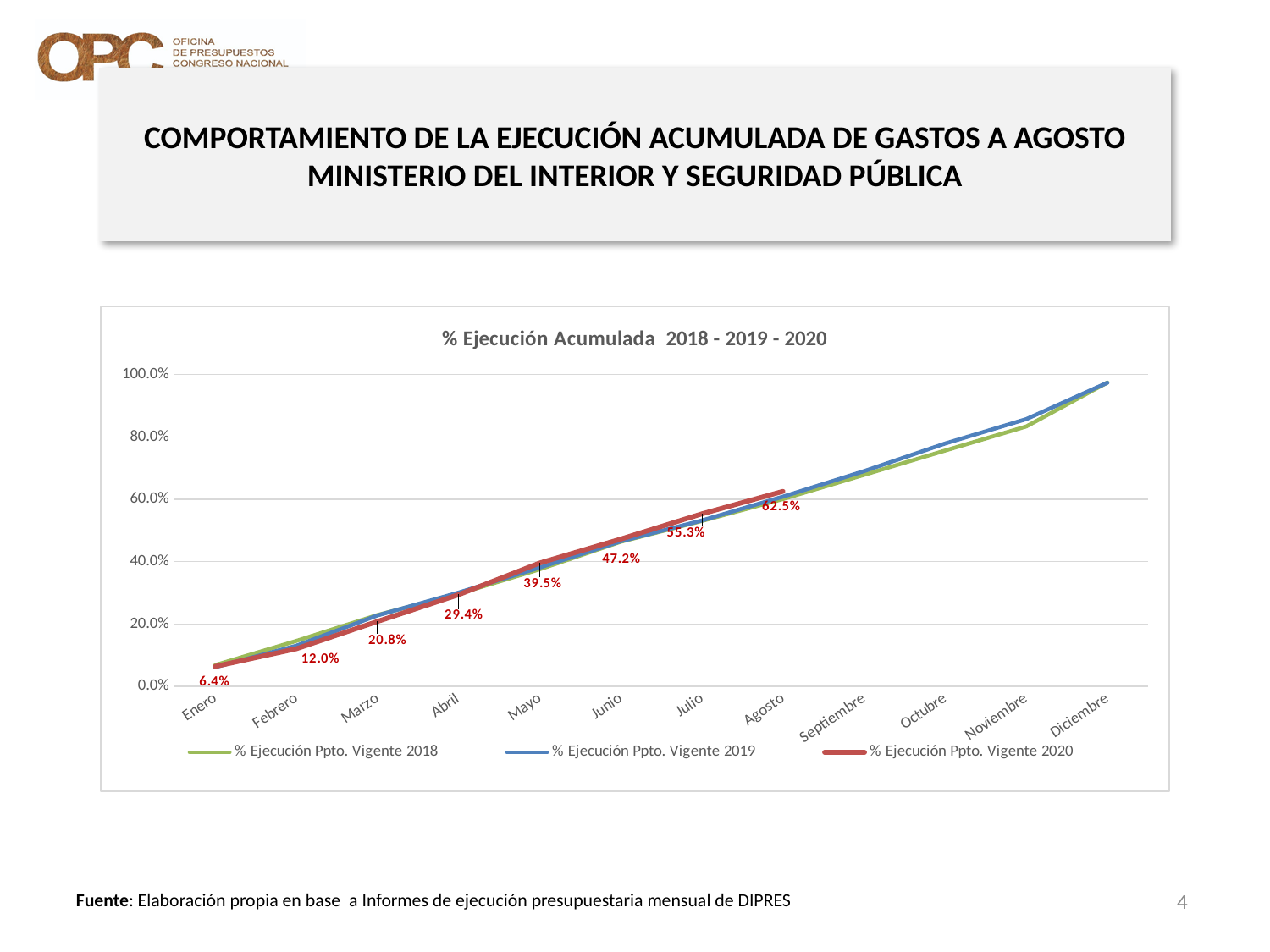
What is the value of % Ejecución Ppto. Vigente 2020 for Mayo? 39.5% What is the value of % Ejecución Ppto. Vigente 2020 for Marzo? 20.8% Is the value for % Ejecución Ppto. Vigente 2018 in Octubre greater or less than 80.0%? less Is the value for % Ejecución Ppto. Vigente 2019 in Diciembre greater or less than 80.0%? greater What is the value of % Ejecución Ppto. Vigente 2020 for Agosto? 62.5% Which month has the highest value for the % Ejecución Ppto. Vigente 2020 series? Agosto Do the values of the series rise or fall from Enero to Diciembre? rise What is the value of % Ejecución Ppto. Vigente 2020 for Enero? 6.4% What kind of chart is shown on the slide? line chart By how many percentage points does the 2020 series increase from Julio to Agosto? 7.2 How many months are shown on the x axis? 12 How many series does the legend list? 3